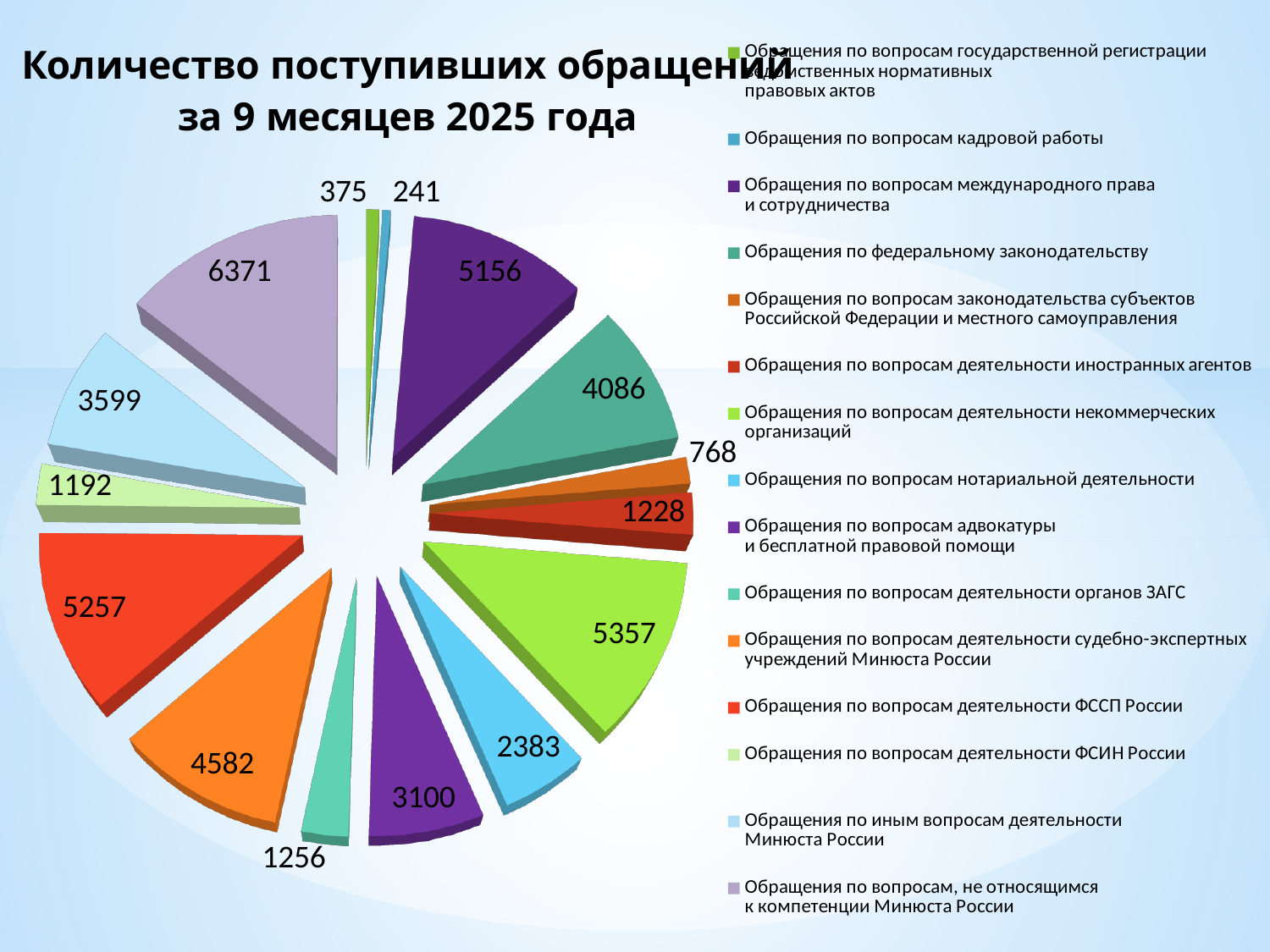
What is the value for "Обращения по вопросам нотариальной деятельности"? 2383 Which category has the smallest slice? Обращения по вопросам кадровой работы How many categories does the legend list? 15 What is the difference between the values for "Обращения по вопросам деятельности ФССП России" and "Обращения по вопросам деятельности судебно-экспертных учреждений Минюста России"? 675 What is the difference between the values for "Обращения по иным вопросам деятельности Минюста России" and "Обращения по вопросам адвокатуры и бесплатной правовой помощи"? 499 What is the value for "Обращения по вопросам деятельности ФССП России"? 5257 What type of chart is shown on the slide? Pie chart Which category has the largest slice? Обращения по вопросам, не относящимся к компетенции Минюста России Which is larger: the value for "Обращения по вопросам международного права и сотрудничества" or for "Обращения по федеральному законодательству"? Обращения по вопросам международного права и сотрудничества What is the value for "Обращения по вопросам, не относящимся к компетенции Минюста России"? 6371 What is the title of the chart? Количество поступивших обращений за 9 месяцев 2025 года What is the value for "Обращения по вопросам кадровой работы"? 241